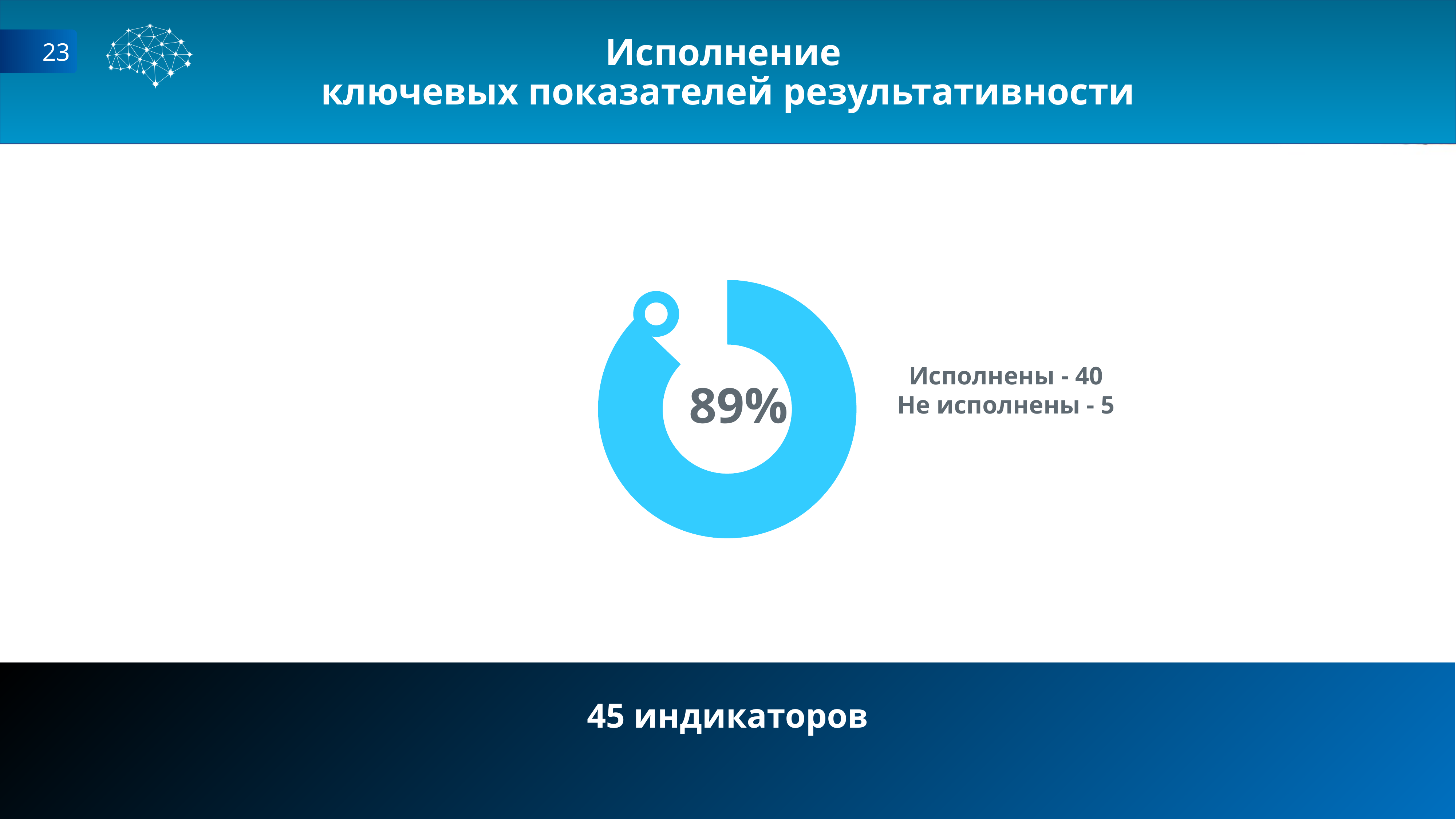
What is the total number of indicators shown on the slide? 45 индикаторов What is the difference between the number of "Исполнены" and "Не исполнены" indicators? 35 How many indicators are listed as "Не исполнены" on the chart? 5 How many categories are listed next to the chart? 2 What percentage is printed in the centre of the ring chart? 89% How many indicators are listed as "Исполнены" on the chart? 40 What kind of chart is shown on the slide? Donut (ring) chart Which category has the smallest number of indicators? Не исполнены Which category has more indicators, "Исполнены" or "Не исполнены"? Исполнены What is the title of the slide containing the chart? Исполнение ключевых показателей результативности What share of the indicators does the filled part of the ring represent? 89% Which category has the largest number of indicators? Исполнены